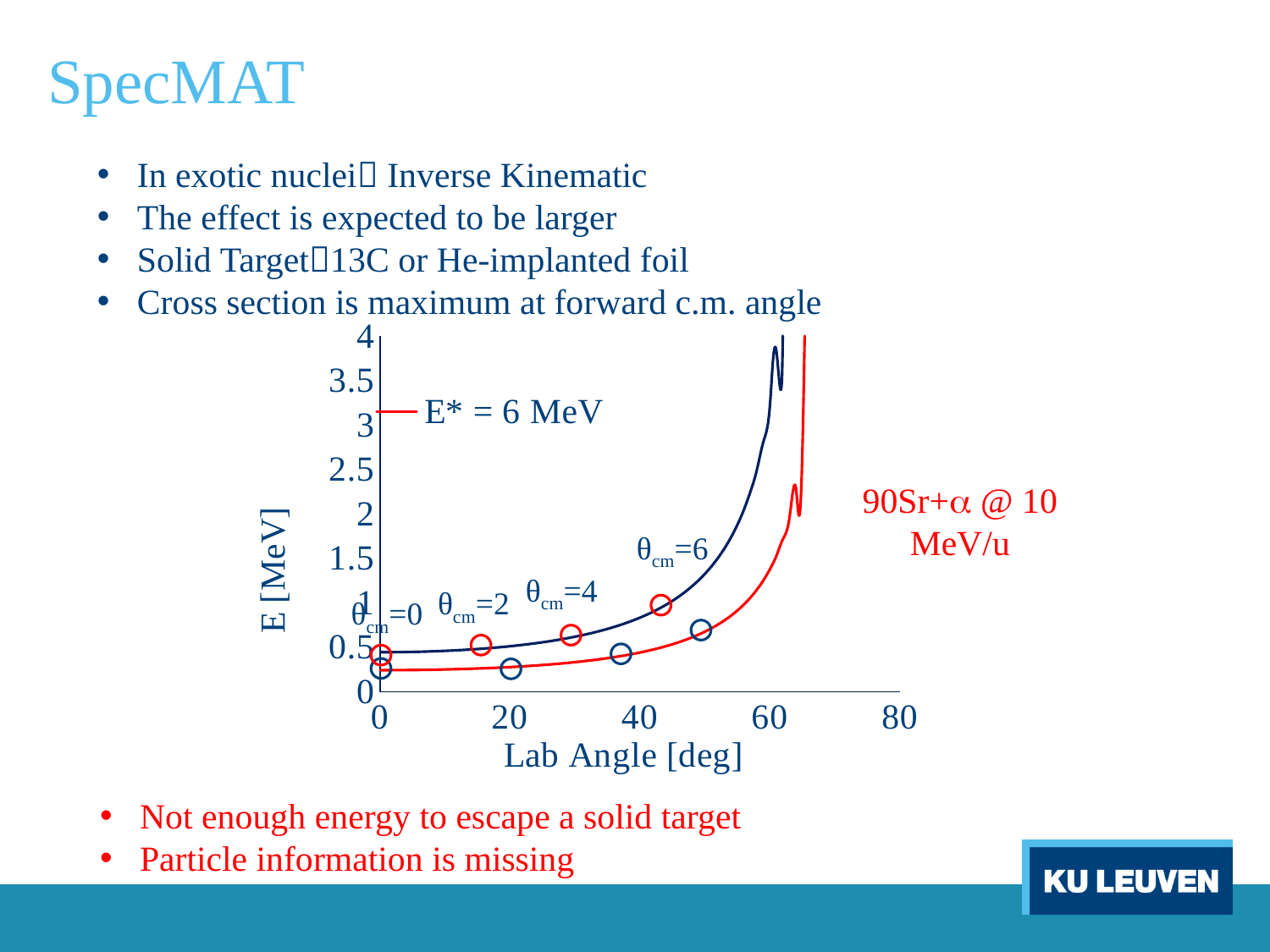
Do the curves rise or fall as the lab angle increases? rise Is the value of the red curve at a lab angle of 20 degrees greater or less than 0.5 MeV? less Is the value of the dark blue curve at a lab angle of 40 degrees greater or less than 0.5 MeV? greater What is the label of the y axis of the chart? E [MeV] What is the highest tick value shown on the x axis of the chart? 80 How many curves are plotted on the chart? 2 What kind of chart is shown on the slide? line chart What is the highest tick value shown on the y axis of the chart? 4 Is the value of the red curve at a lab angle of 60 degrees greater or less than 1 MeV? greater At a lab angle of 40 degrees, which curve has the higher energy, the dark blue curve or the red curve? dark blue curve